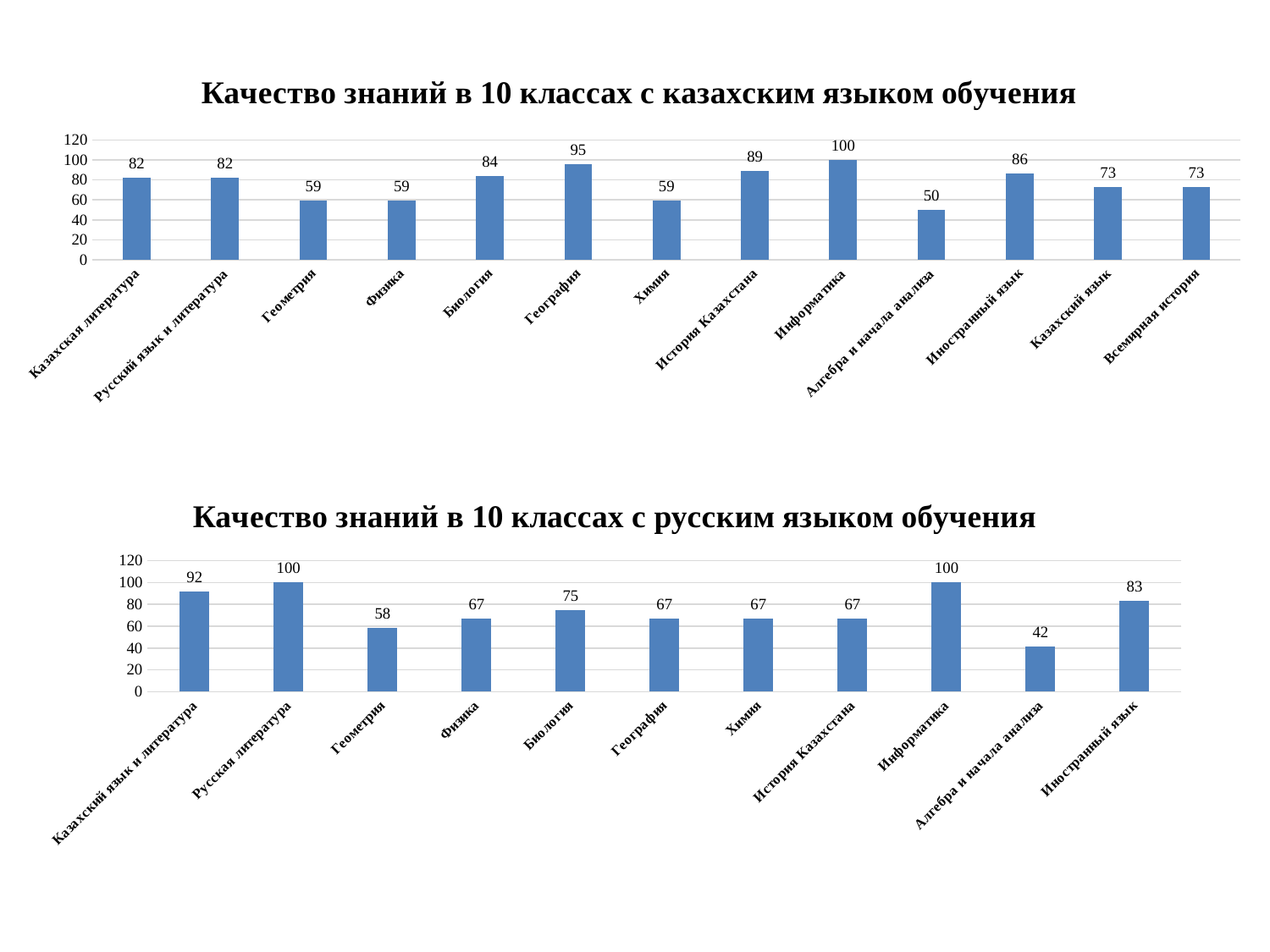
In the top chart (Качество знаний в 10 классах с казахским языком обучения), which is larger, Биология or Иностранный язык? Иностранный язык In the top chart (Качество знаний в 10 классах с казахским языком обучения), what is the value for География? 95 In the top chart (Качество знаний в 10 классах с казахским языком обучения), how many categories are shown? 13 In the top chart (Качество знаний в 10 классах с казахским языком обучения), what is the difference between Информатика and Алгебра и начала анализа? 50 In the bottom chart (Качество знаний в 10 классах с русским языком обучения), which category has the lowest value? Алгебра и начала анализа In the top chart (Качество знаний в 10 классах с казахским языком обучения), which category has the lowest value? Алгебра и начала анализа In the bottom chart (Качество знаний в 10 классах с русским языком обучения), is the value for Биология greater or less than 60? greater In the bottom chart (Качество знаний в 10 классах с русским языком обучения), what is the difference between Иностранный язык and Геометрия? 25 What type of chart is the bottom chart (Качество знаний в 10 классах с русским языком обучения)? Bar chart In the bottom chart (Качество знаний в 10 классах с русским языком обучения), how many categories are shown? 11 In the top chart (Качество знаний в 10 классах с казахским языком обучения), what is the value for Информатика? 100 In the bottom chart (Качество знаний в 10 классах с русским языком обучения), what is the value for Казахский язык и литература? 92